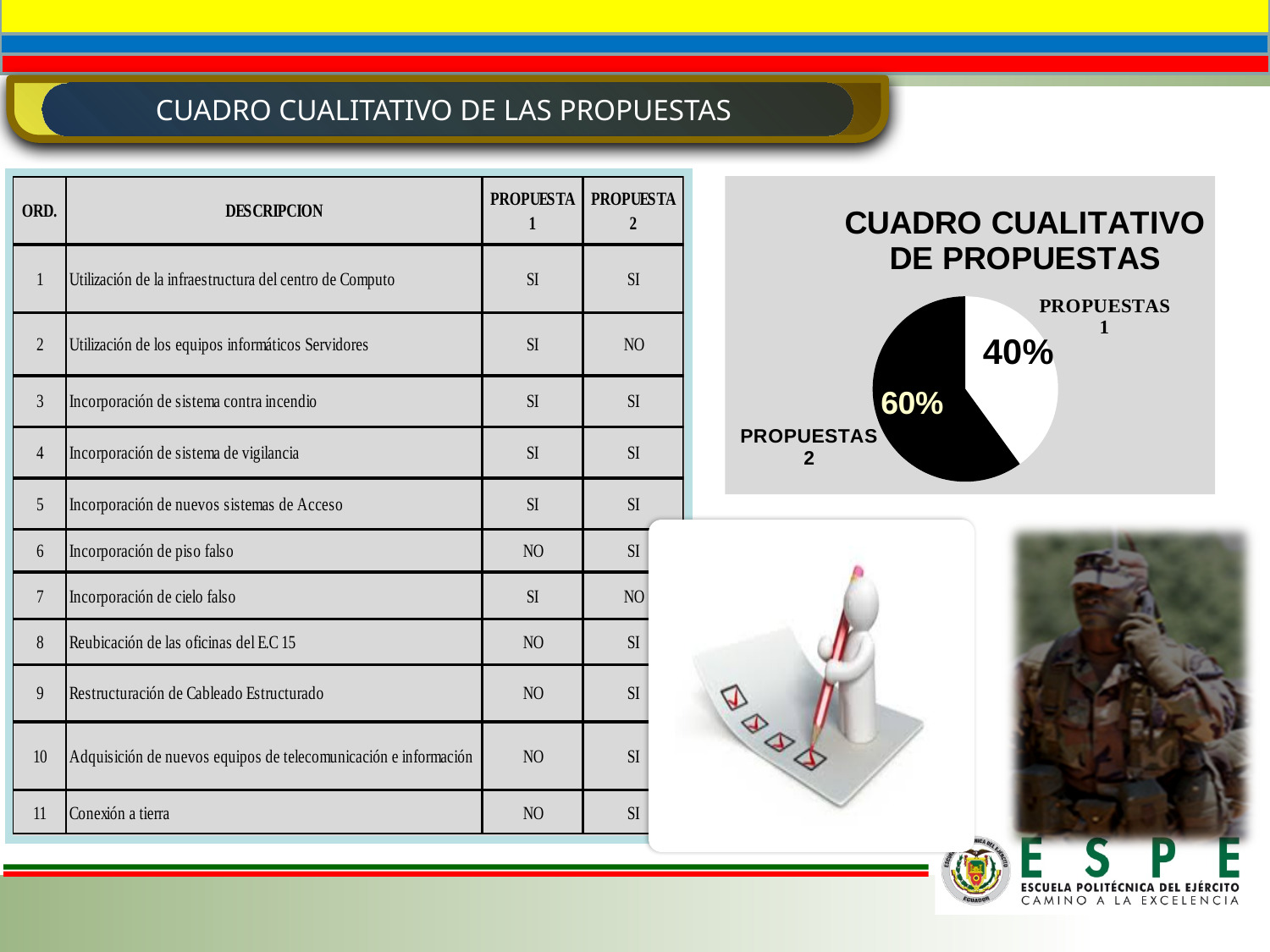
What share of the pie does PROPUESTAS 2 have? 60% Which slice of the pie is the largest? PROPUESTAS 2 What share of the pie does PROPUESTAS 1 have? 40% What is the title of the chart? CUADRO CUALITATIVO DE PROPUESTAS How many slices does the pie chart have? 2 Which slice of the pie is the smallest? PROPUESTAS 1 What kind of chart is shown on the slide? pie chart What is the difference between the shares of PROPUESTAS 2 and PROPUESTAS 1? 20% What colour is the PROPUESTAS 2 slice of the pie? black Which is larger, the share for PROPUESTAS 1 or for PROPUESTAS 2? PROPUESTAS 2